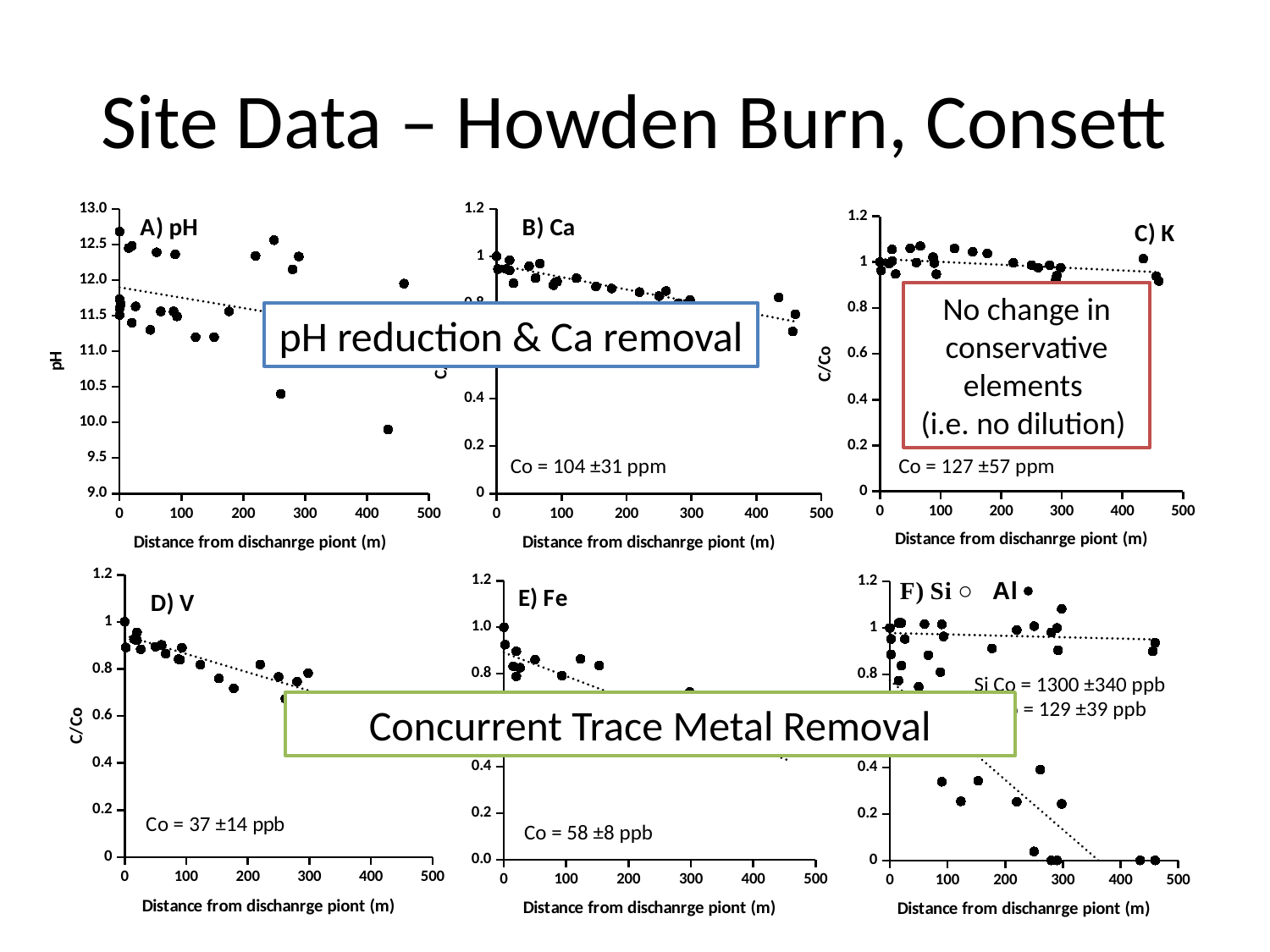
How many charts are shown on the slide? 6 In chart "C) K", is the C/Co value at 0 m greater or less than 0.8? greater In chart "F) Si / Al", is the Al value at about 430 m greater or less than 0.2? less How many series does the legend of chart "F)" list? 2 In chart "A) pH", is the pH value at about 430 m greater or less than 10.5? less In chart "D) V", do the C/Co values rise or fall as distance from the discharge point increases? fall What is the x-axis label of chart "A) pH"? Distance from dischanrge piont (m) What kind of chart is "A) pH"? scatter chart In chart "B) Ca", do the C/Co values rise or fall along the x axis? fall In chart "D) V", which is larger, the C/Co value at 0 m or the value at about 300 m? 0 m